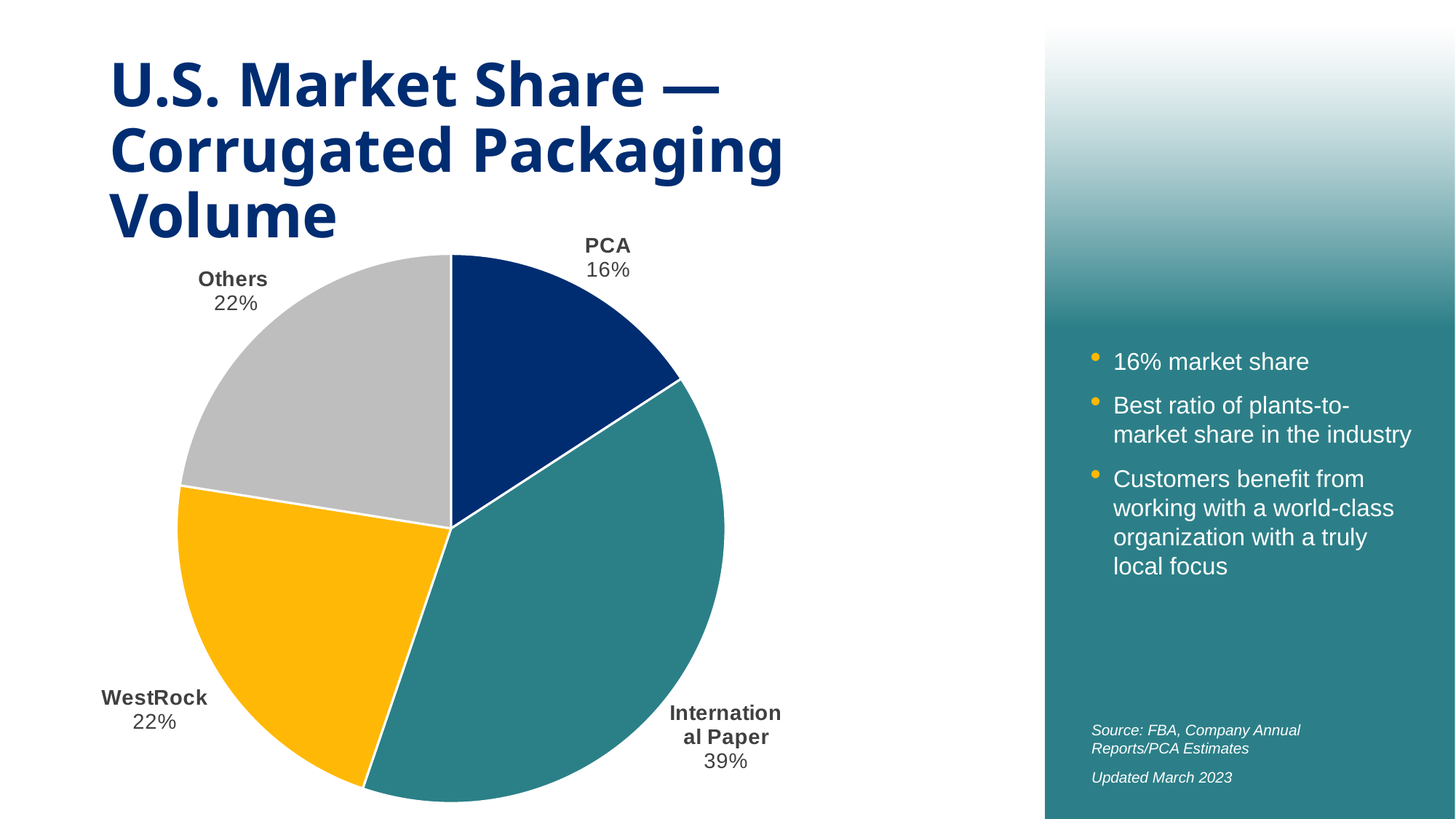
What is the difference in percentage points between International Paper's share and PCA's share? 23 What share of the pie does WestRock hold? 22% Which slice of the pie is the largest? International Paper Which has a larger share, WestRock or PCA? WestRock What colour is the PCA slice of the pie? Dark blue What share of the pie does International Paper hold? 39% What is the combined share of WestRock and Others? 44% What kind of chart is shown on the slide? Pie chart What share of the pie does PCA hold? 16% How many slices does the pie chart have? 4 What share of the pie does Others hold? 22% Which slice of the pie is the smallest? PCA